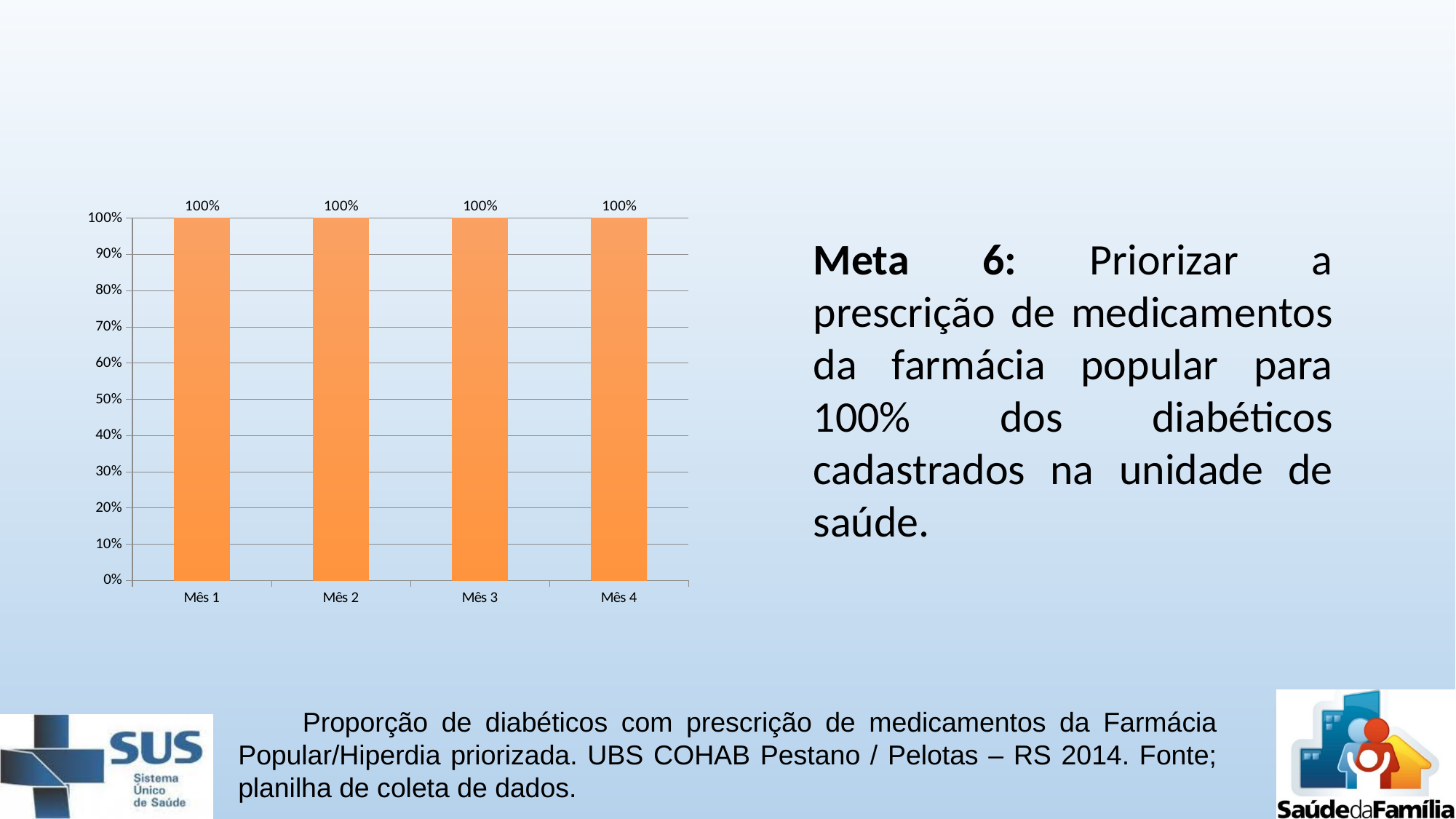
What is the value for Mês 3? 100% What kind of chart is shown on the slide? bar chart What is the value for Mês 1? 100% Are the values for Mês 1 and Mês 3 equal? yes Do the values rise, fall or stay the same from Mês 1 to Mês 4? stay the same Is the value for Mês 2 greater or less than 50%? greater What is the label of the first category on the x axis? Mês 1 What colour are the bars in the chart? orange What is the value for Mês 4? 100% What is the difference between the values for Mês 2 and Mês 4? 0% How many categories are shown on the x axis? 4